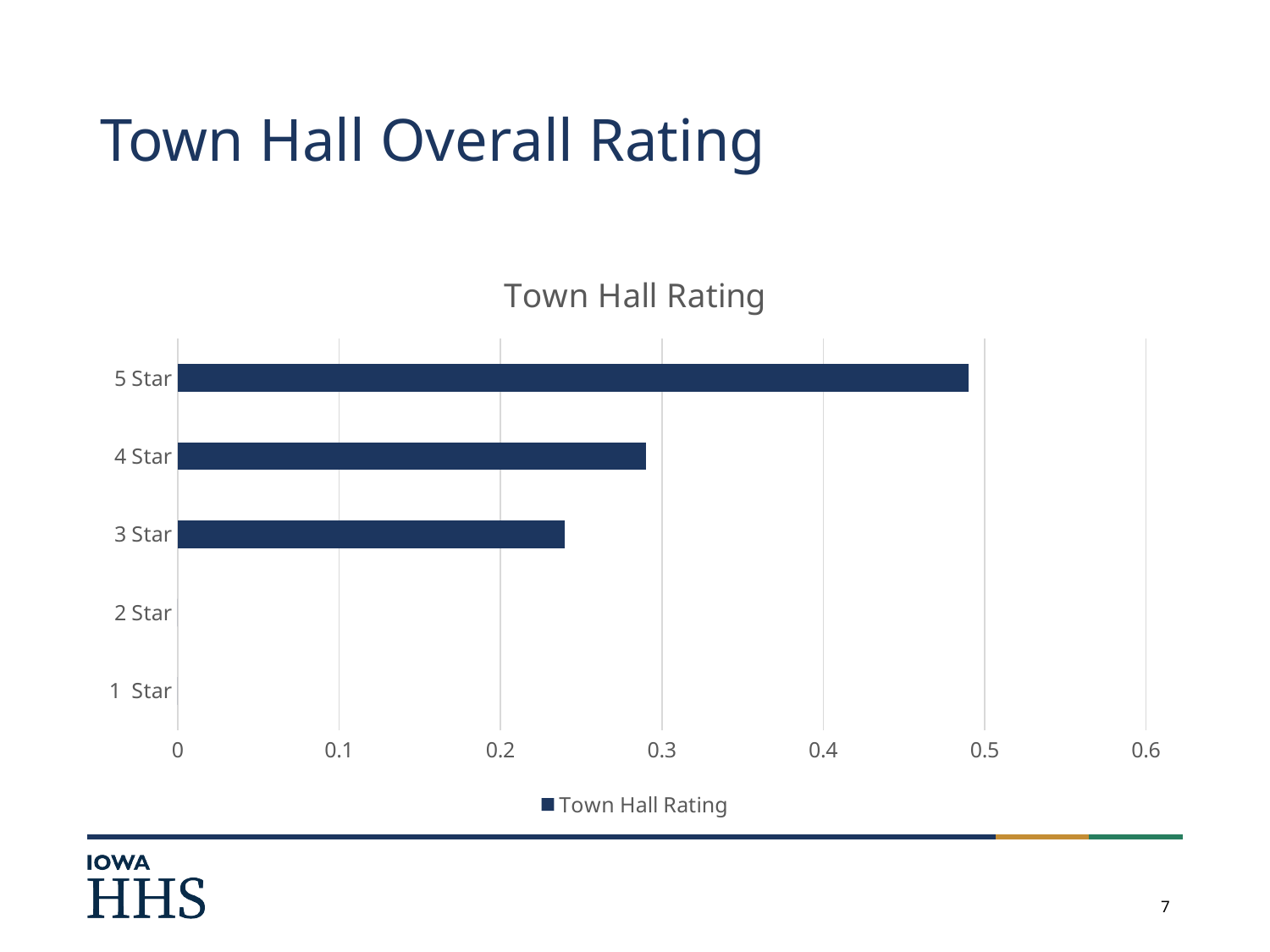
How many rating categories are shown on the chart? 5 How many series does the legend list? 1 Is the value for 5 Star greater or less than 0.4? greater Which is larger, the value for 5 Star or the value for 4 Star? 5 Star What is the title of the chart? Town Hall Rating Is the value for 3 Star greater or less than 0.2? greater Which rating category has the highest value in the Town Hall Rating chart? 5 Star Which is larger, the value for 4 Star or the value for 3 Star? 4 Star What kind of chart is shown on the slide? bar chart Is the value for 2 Star greater or less than 0.1? less What series name appears in the chart legend? Town Hall Rating